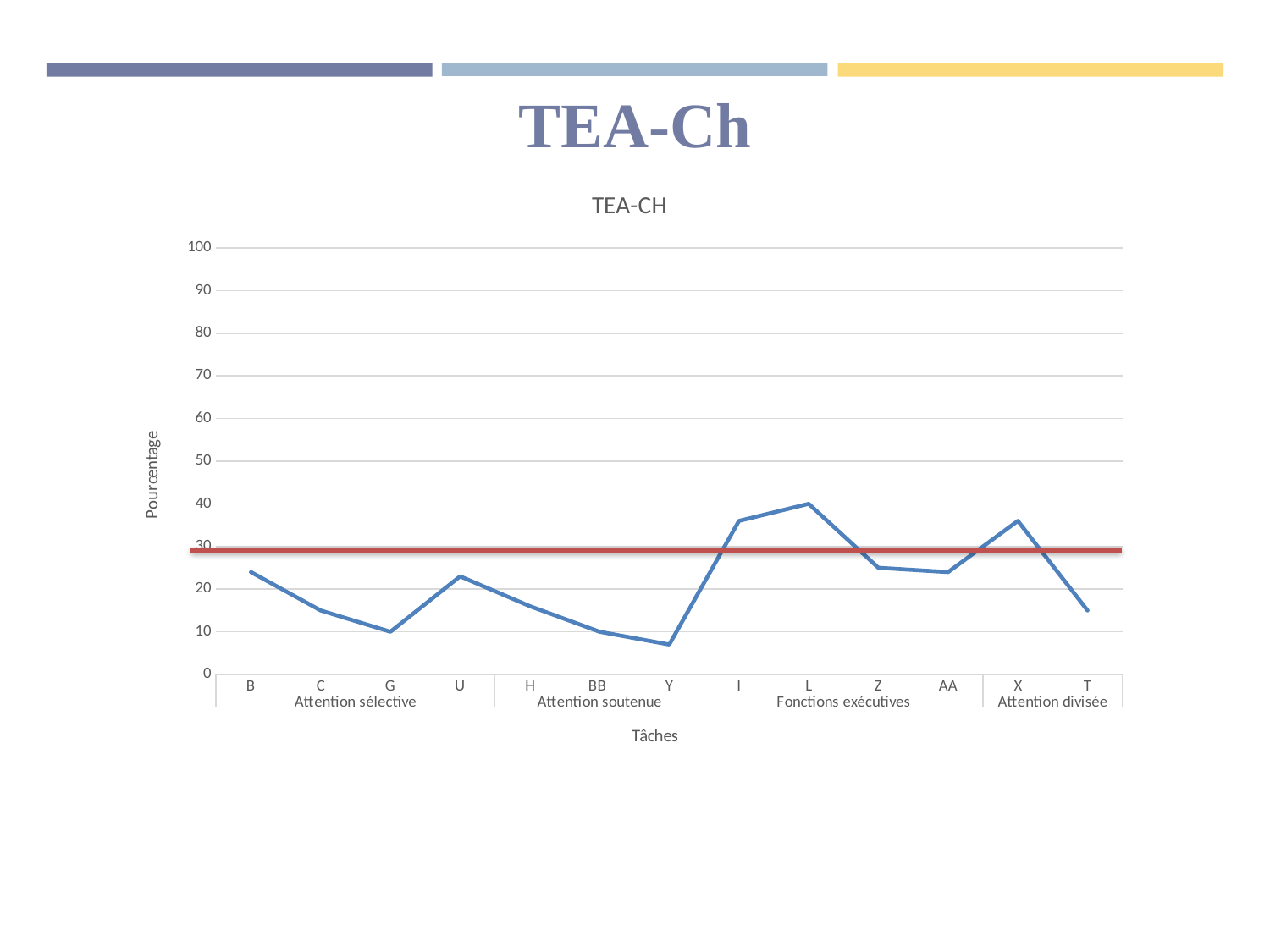
Is the value for T greater or less than 20? less Which task has the highest value? L Is the value for I greater or less than 30? greater What kind of chart is shown on the slide? line chart Which task has the lowest value? Y Is the value for Y greater or less than 10? less What is the title of the y axis? Pourcentage Which is larger, the value for X or the value for T? X How many task categories are plotted along the x axis? 13 Do the values rise or fall from X to T? fall